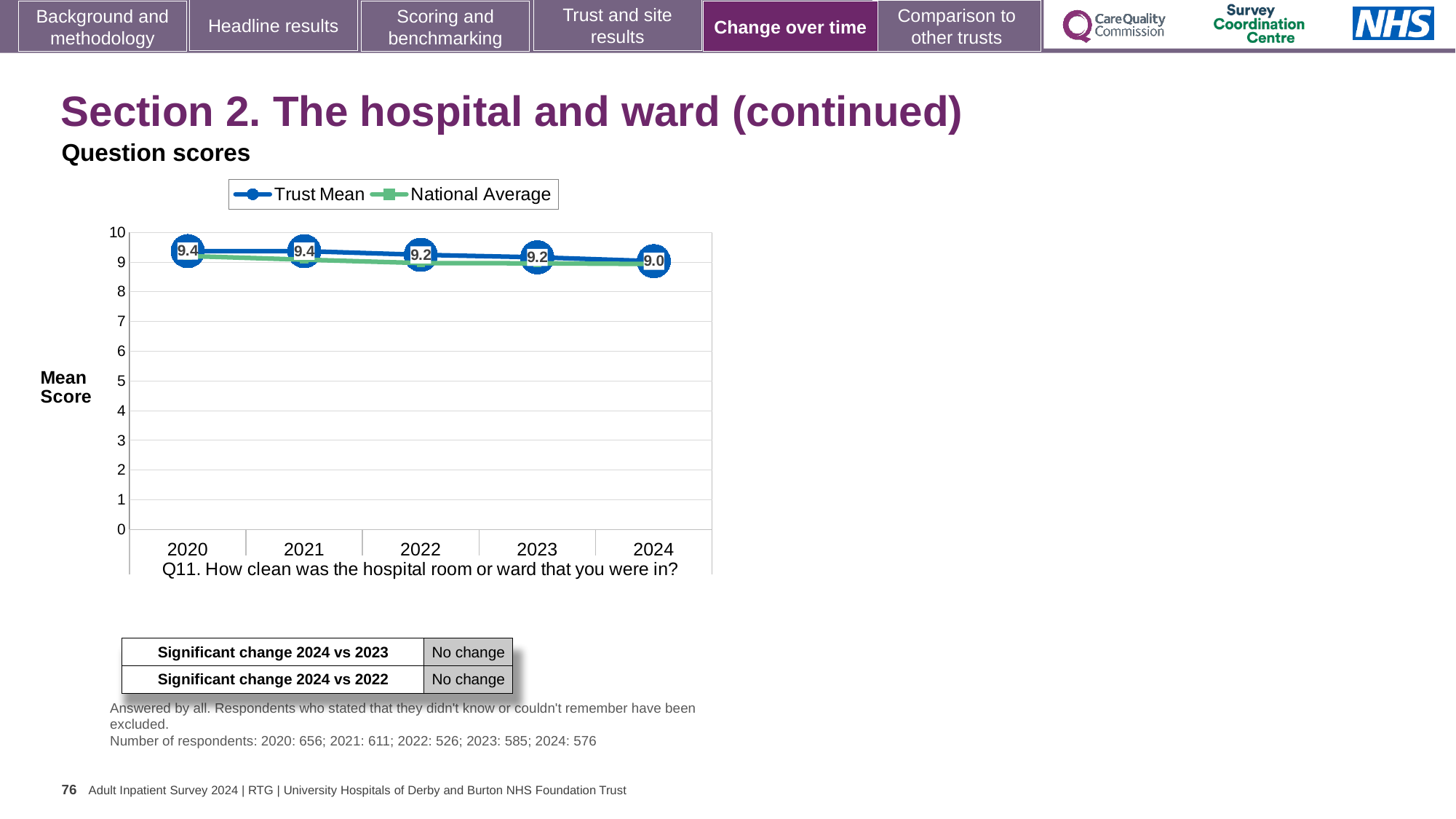
Is the National Average value for 2024 greater or less than 8? greater In which year is the Trust Mean lowest? 2024 Does the Trust Mean rise or fall from 2020 to 2024? fall What is the label on the y axis? Mean Score How many series does the legend list? 2 How many years are shown on the x axis? 5 What is the Trust Mean value for 2020? 9.4 What kind of chart is shown? line chart What is the Trust Mean value for 2022? 9.2 What is the Trust Mean value for 2024? 9.0 What is the difference between the Trust Mean in 2020 and in 2024? 0.4 Which is larger, the Trust Mean in 2021 or in 2024? 2021